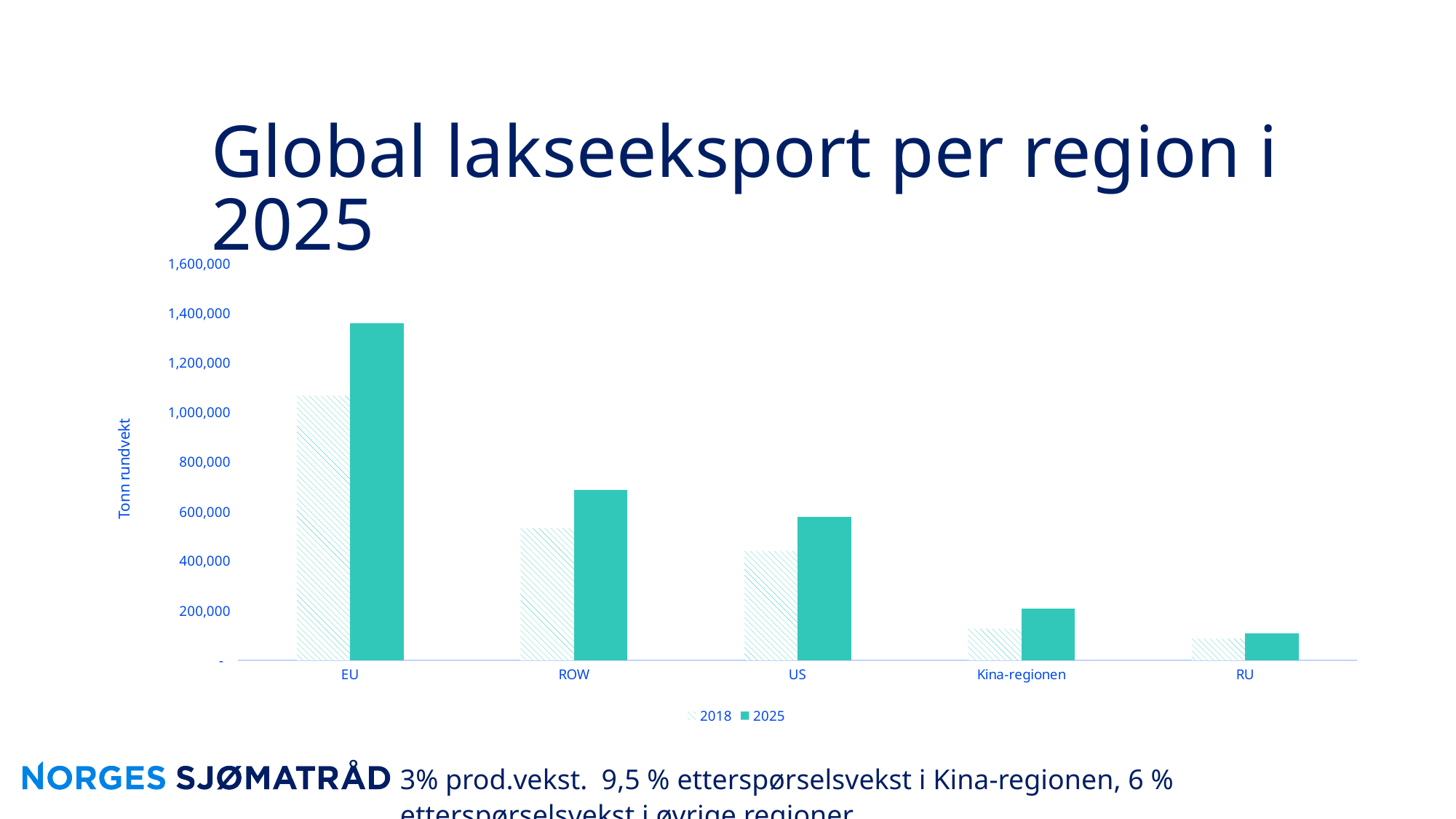
Which region has the lowest value for 2025? RU What kind of chart is shown on the slide? bar chart Which region has the highest value for 2025? EU What is the label on the vertical axis? Tonn rundvekt How many regions are shown on the x axis? 5 Which is larger, the 2025 value for ROW or the 2025 value for US? ROW How many series does the legend list? 2 Which is larger, the 2018 value for EU or the 2025 value for EU? 2025 Is the 2025 value for EU greater or less than 1,200,000? greater Which region has the lowest value for 2018? RU Is the 2018 value for US greater or less than 600,000? less